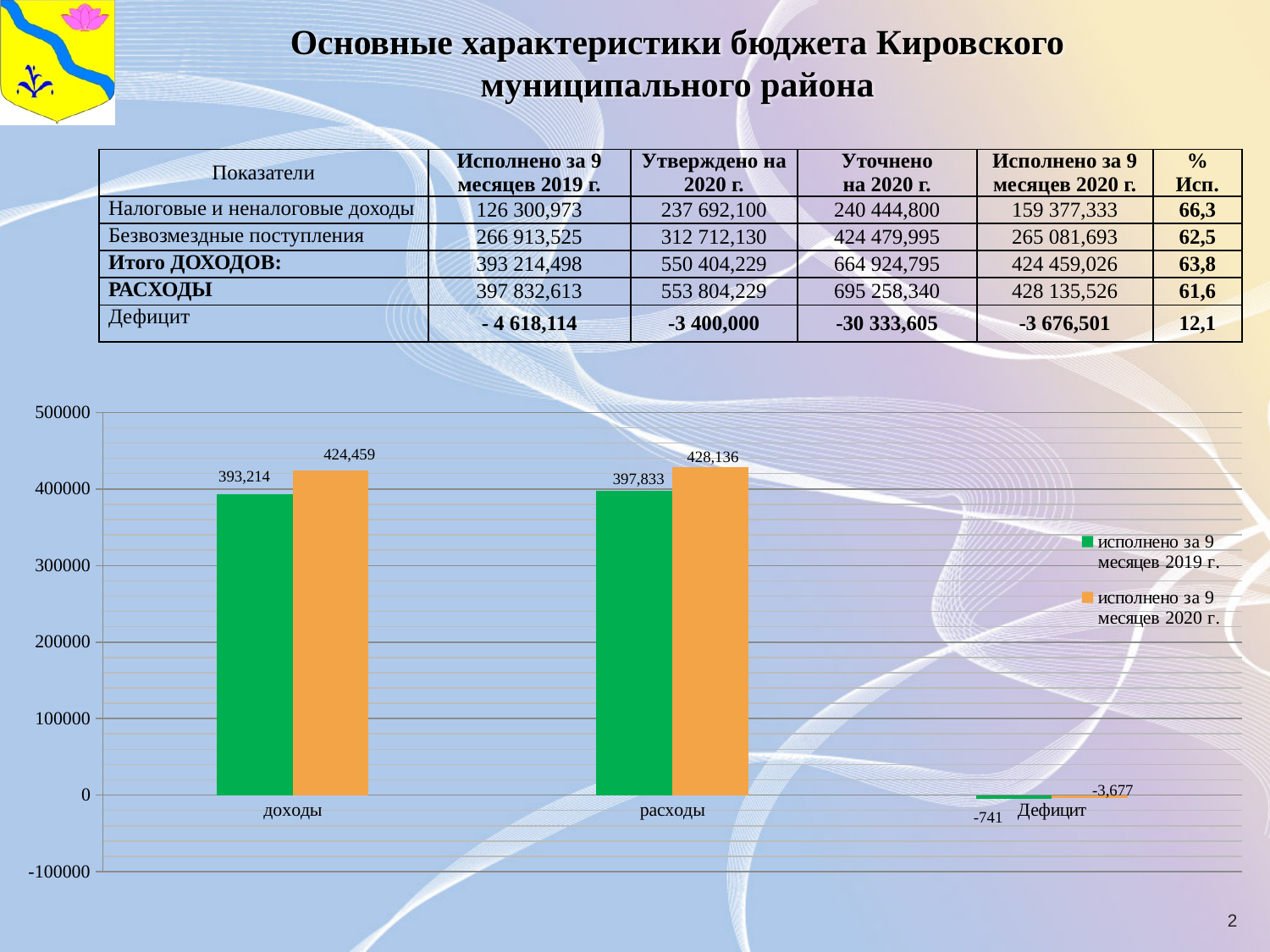
What is the value for Дефицит in the series исполнено за 9 месяцев 2020 г.? -3,677 What is the value for расходы in the series исполнено за 9 месяцев 2019 г.? 397,833 What is the value for расходы in the series исполнено за 9 месяцев 2020 г.? 428,136 Which series is shown in orange in the chart? исполнено за 9 месяцев 2020 г. How many series does the chart legend list? 2 What is the difference between расходы and доходы in the series исполнено за 9 месяцев 2020 г.? 3,677 What is the value for доходы in the series исполнено за 9 месяцев 2019 г.? 393,214 What is the value for доходы in the series исполнено за 9 месяцев 2020 г.? 424,459 Which is larger for расходы: the value for исполнено за 9 месяцев 2019 г. or исполнено за 9 месяцев 2020 г.? исполнено за 9 месяцев 2020 г. Which category has the lowest value in the series исполнено за 9 месяцев 2020 г.? Дефицит What type of chart is shown on the slide? bar chart How many categories are shown on the x axis of the chart? 3